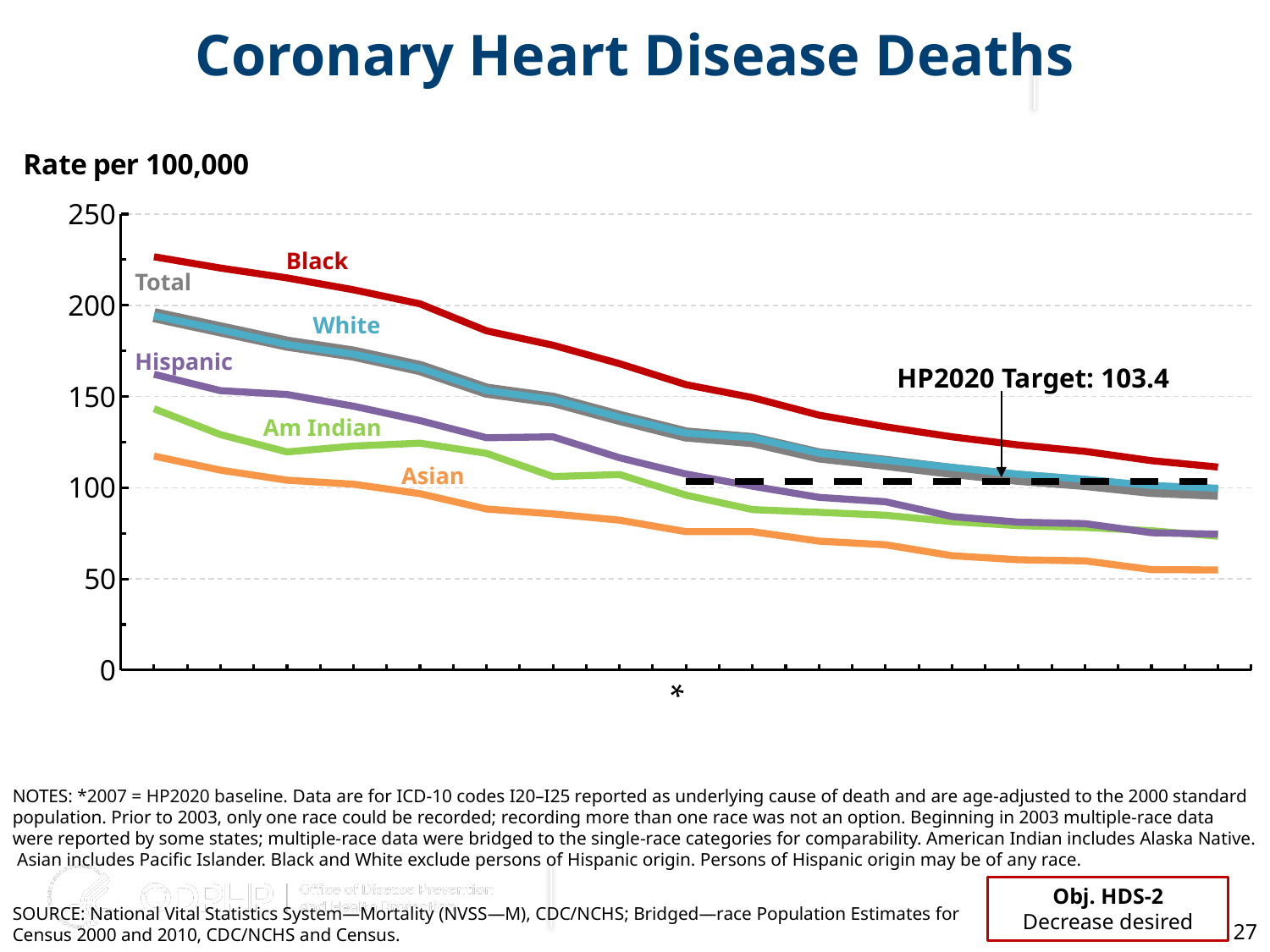
Is the rate for Asian at the end of the chart greater or less than 100? less What is the HP2020 Target value shown on the chart? 103.4 At the start of the chart, which is larger, the rate for Black or the rate for Asian? Black Which group has the highest coronary heart disease death rate throughout the chart? Black How many data series (lines) are labeled on the chart? 6 Is the rate for Am Indian at the end of the chart greater or less than 100? less What unit is the y axis measured in, according to the label above the chart? Rate per 100,000 Is the rate for Black at the end of the chart greater or less than 100? greater Do the death rates rise or fall over time along the x axis? fall What kind of chart is shown on the slide? line chart Which group has the lowest coronary heart disease death rate throughout the chart? Asian